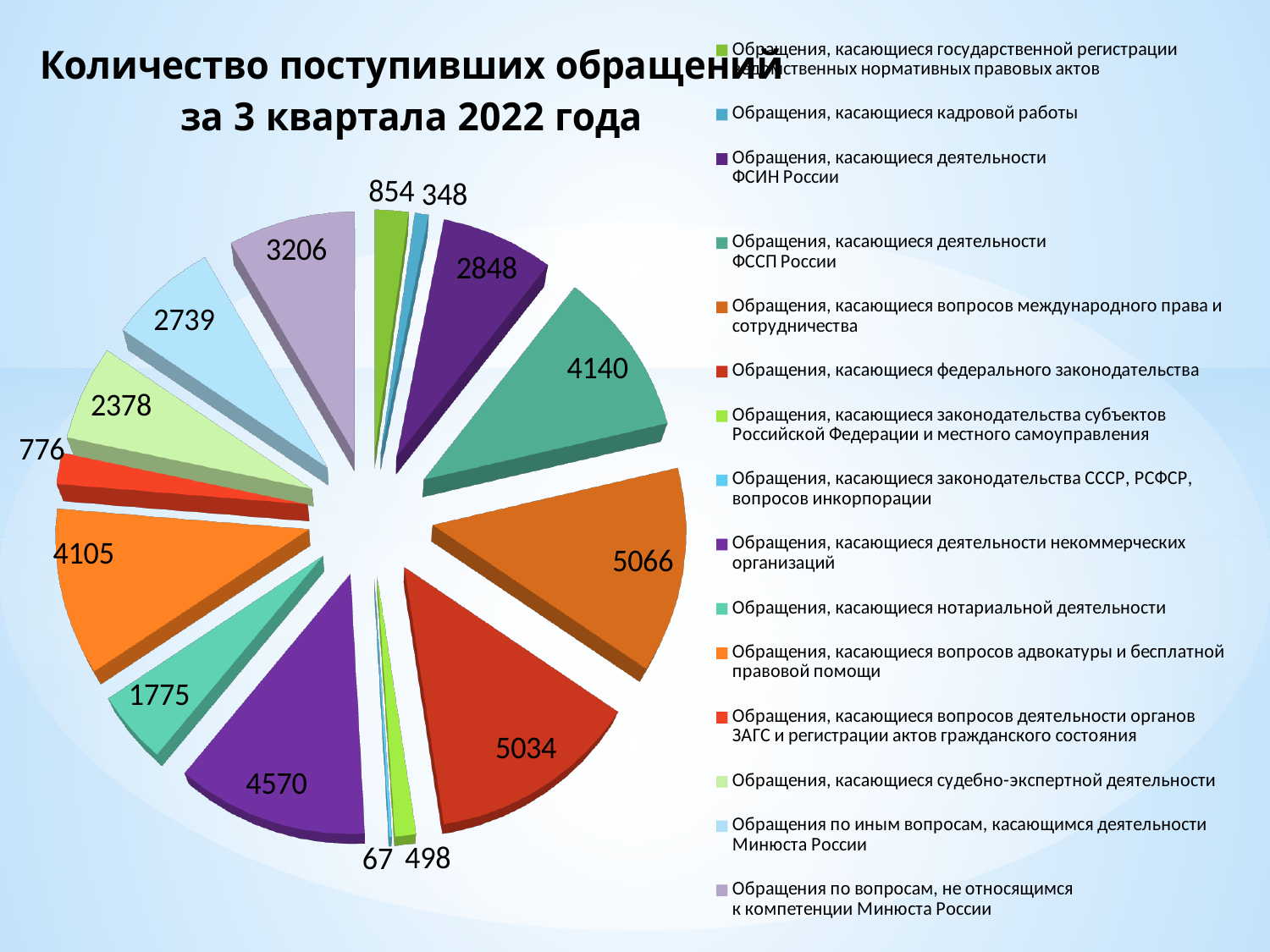
How many slices does the pie chart have? 15 What type of chart is shown on the slide? Pie chart What is the value for 'Обращения, касающиеся деятельности ФССП России'? 4140 What is the difference between the values for 'Обращения, касающиеся вопросов международного права и сотрудничества' and 'Обращения, касающиеся федерального законодательства'? 32 Which is larger: the value for 'Обращения, касающиеся деятельности некоммерческих организаций' or for 'Обращения, касающиеся деятельности ФСИН России'? Обращения, касающиеся деятельности некоммерческих организаций What is the difference between the values for 'Обращения по вопросам, не относящимся к компетенции Минюста России' and 'Обращения по иным вопросам, касающимся деятельности Минюста России'? 467 What is the value for 'Обращения, касающиеся нотариальной деятельности'? 1775 What is the title of the chart? Количество поступивших обращений за 3 квартала 2022 года Which category has the smallest value? Обращения, касающиеся законодательства СССР, РСФСР, вопросов инкорпорации How many entries does the legend list? 15 Which category has the largest value? Обращения, касающиеся вопросов международного права и сотрудничества What is the value for 'Обращения, касающиеся вопросов международного права и сотрудничества'? 5066